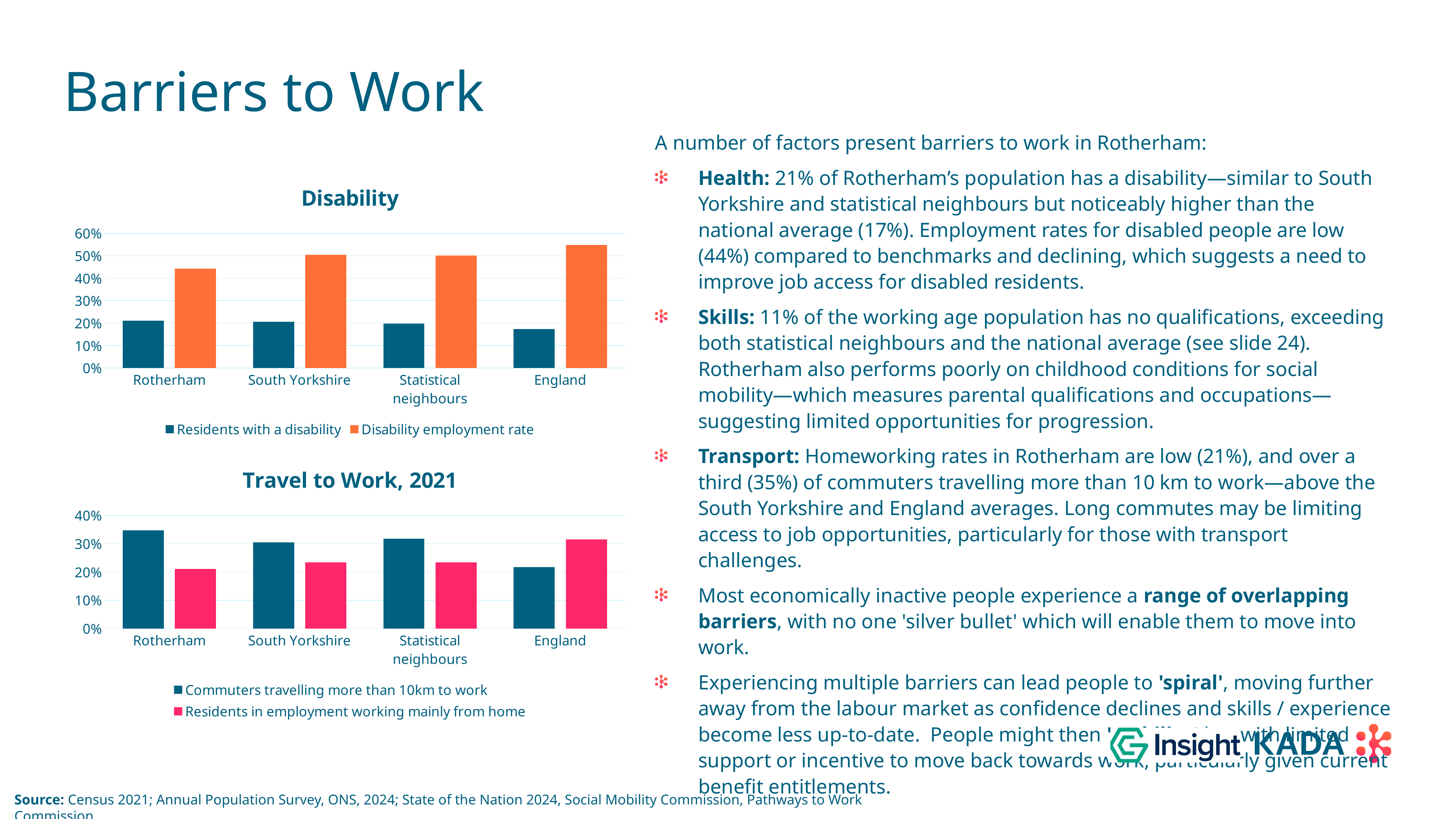
In the Disability chart, is the disability employment rate for Rotherham greater or less than 50%? less What kind of chart is the Disability chart? bar chart How many categories are shown on the x axis of the Travel to Work, 2021 chart? 4 In the Disability chart, is the share of residents with a disability in England greater or less than 20%? less In the Travel to Work, 2021 chart, which category has the highest share of commuters travelling more than 10km to work? Rotherham In the Travel to Work, 2021 chart, for England, which is larger: commuters travelling more than 10km to work or residents in employment working mainly from home? Residents in employment working mainly from home In the Disability chart, which category has the highest disability employment rate? England In the Disability chart, which category has the lowest disability employment rate? Rotherham In the Travel to Work, 2021 chart, is the share of commuters travelling more than 10km to work in Rotherham greater or less than 30%? greater In the Disability chart, which has the larger share of residents with a disability, Rotherham or England? Rotherham How many series does the legend of the Disability chart list? 2 In the Travel to Work, 2021 chart, which category has the highest share of residents in employment working mainly from home? England